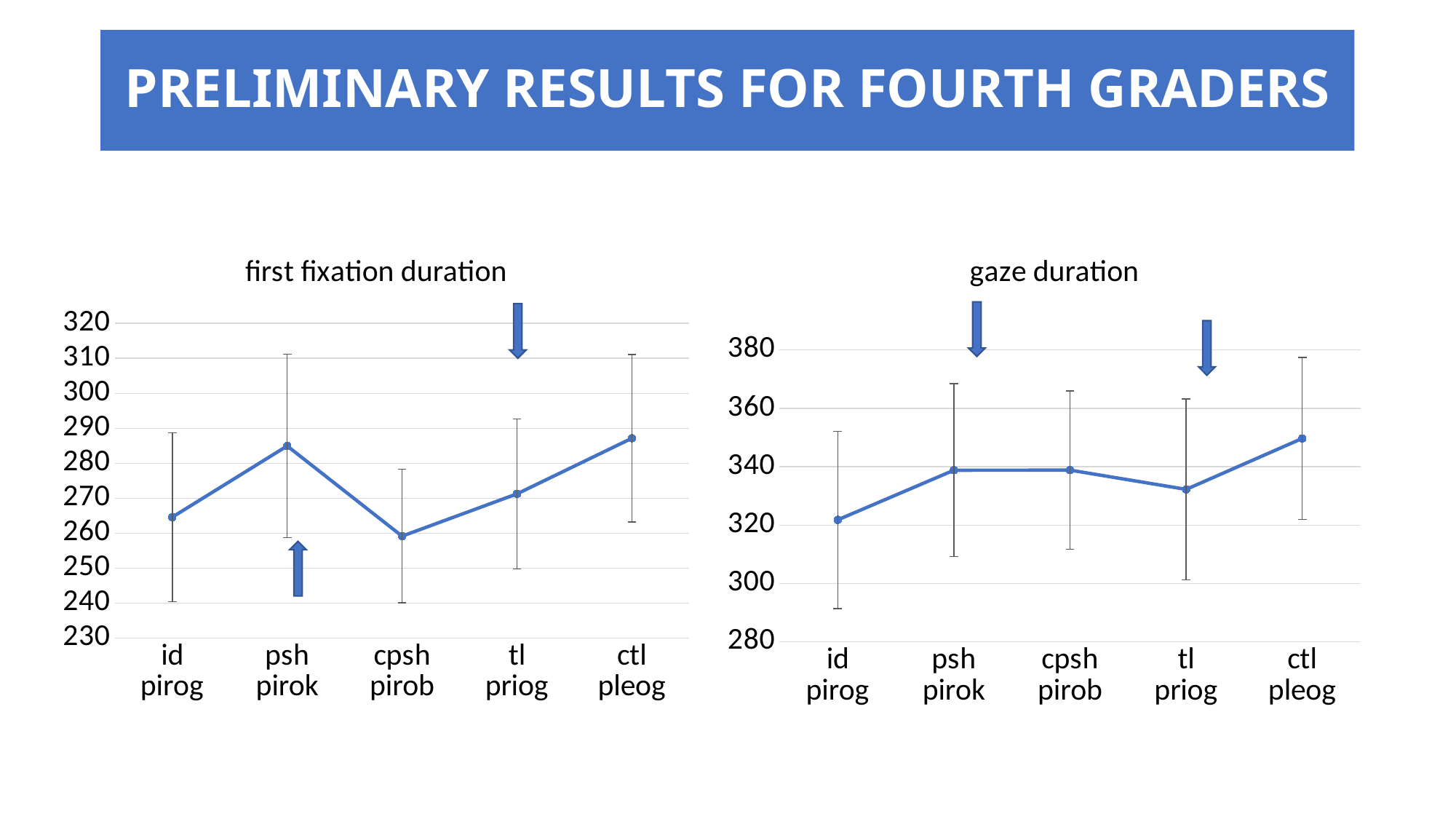
On the 'first fixation duration' chart, is the value for psh pirok greater or less than 280? greater On the 'gaze duration' chart, is the value for id pirog greater or less than 340? less On the 'gaze duration' chart, is the value for ctl pleog greater or less than 340? greater On the 'gaze duration' chart, which is larger, the value for tl priog or the value for ctl pleog? ctl pleog How many categories are plotted on the 'gaze duration' chart? 5 On the 'first fixation duration' chart, which is larger, the value for psh pirok or the value for cpsh pirob? psh pirok On the 'gaze duration' chart, which category has the highest value? ctl pleog What kind of chart is the 'first fixation duration' chart? line chart What is the title of the chart on the right side of the slide? gaze duration On the 'gaze duration' chart, which category has the lowest value? id pirog